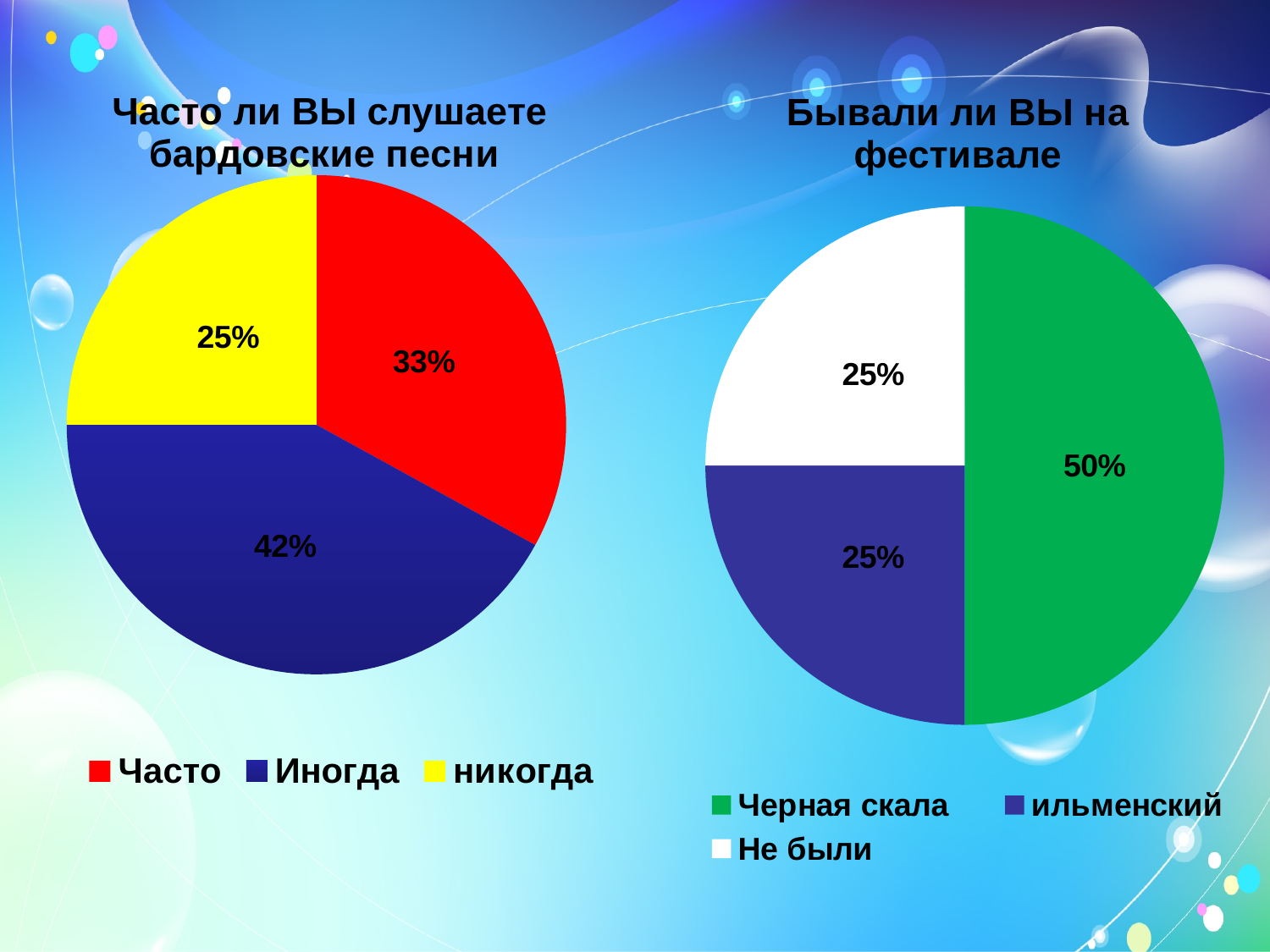
In the chart titled "Часто ли ВЫ слушаете бардовские песни", which category has the largest slice? Иногда In the chart titled "Бывали ли ВЫ на фестивале", how many categories does the legend list? 3 In the chart titled "Бывали ли ВЫ на фестивале", what share does "ильменский" have? 25% In the chart titled "Часто ли ВЫ слушаете бардовские песни", what is the difference between the shares of "Иногда" and "Часто"? 9% In the chart titled "Бывали ли ВЫ на фестивале", what share does "Черная скала" have? 50% What kind of chart is the chart titled "Бывали ли ВЫ на фестивале"? Pie chart In the chart titled "Часто ли ВЫ слушаете бардовские песни", what share does "никогда" have? 25% In the chart titled "Часто ли ВЫ слушаете бардовские песни", what share does "Иногда" have? 42% In the chart titled "Бывали ли ВЫ на фестивале", which category has the largest slice? Черная скала In the chart titled "Часто ли ВЫ слушаете бардовские песни", what share does "Часто" have? 33% In the chart titled "Часто ли ВЫ слушаете бардовские песни", which category has the smallest slice? никогда In the chart titled "Часто ли ВЫ слушаете бардовские песни", what colour is the "никогда" slice? Yellow